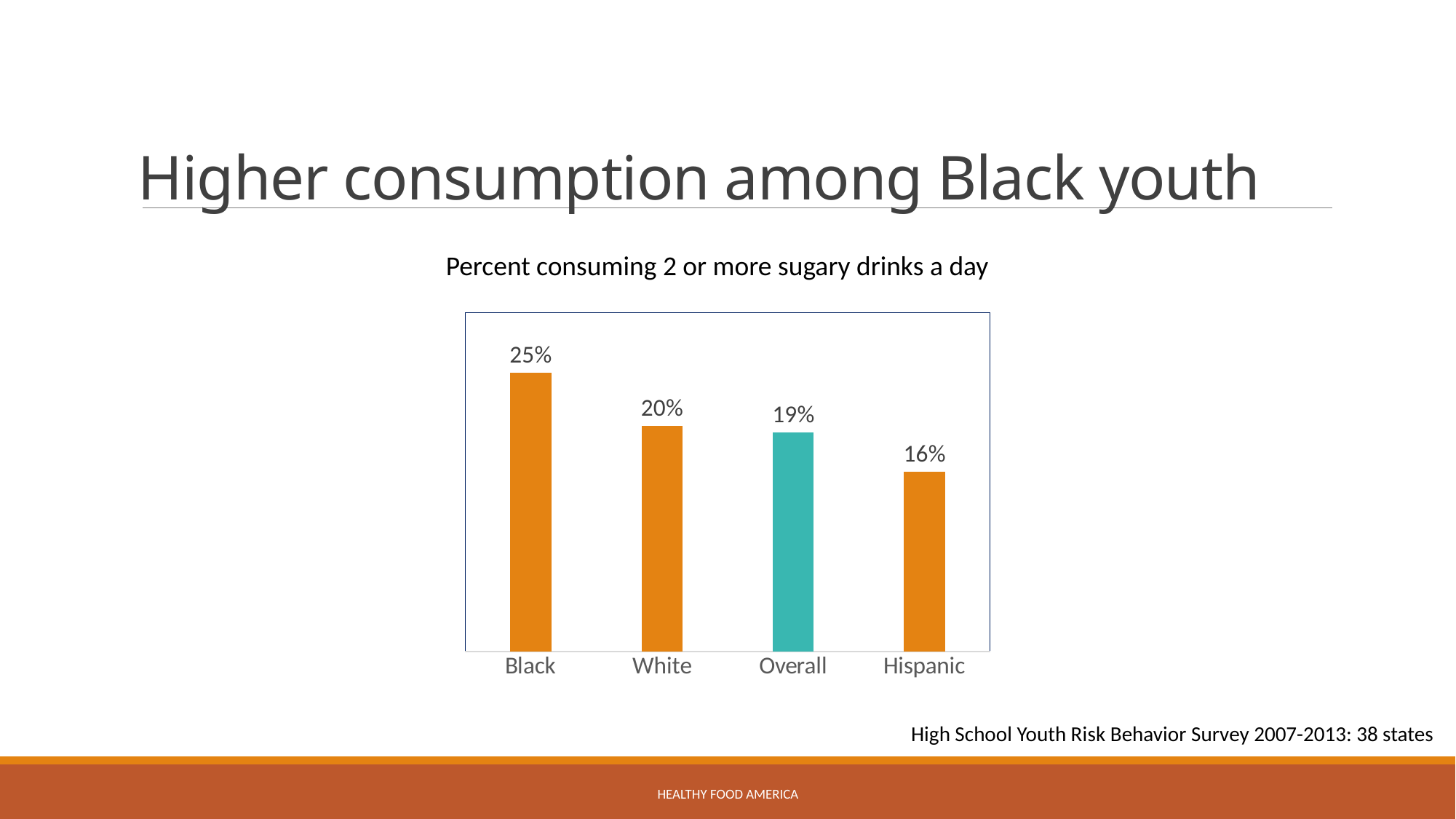
Which category has the highest value? Black What is the difference between the values for Black and Hispanic? 9% What kind of chart is shown on the slide? Bar chart What percent of Black youth consume 2 or more sugary drinks a day? 25% How many categories are shown on the chart? 4 Which is larger, the value for Black or the value for White? Black Which bar is shown in a different colour (teal) from the others? Overall What is the difference between the values for White and Overall? 1% What is the value shown for White? 20% What is the value shown for Overall? 19% What is the value shown for Hispanic? 16% Which category has the lowest value? Hispanic